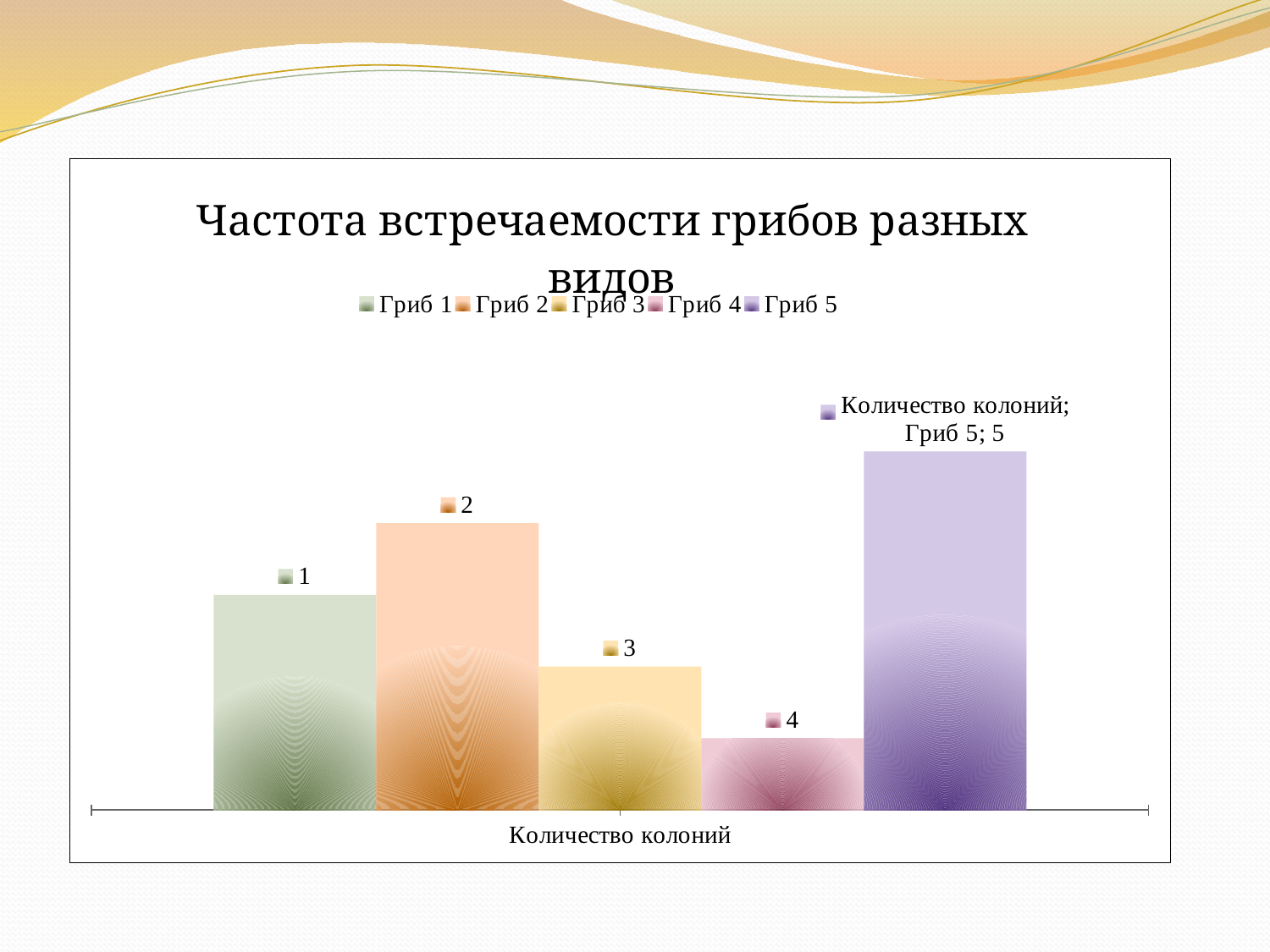
How many bars are plotted in the chart? 5 What is the title of the chart? Частота встречаемости грибов разных видов What value is shown in the data label for Гриб 5? 5 Which bar is taller, Гриб 3 or Гриб 4? Гриб 3 Which bar is taller, Гриб 1 or Гриб 3? Гриб 1 What label is shown on the horizontal axis of the chart? Количество колоний Which mushroom (Гриб) has the shortest bar? Гриб 4 How many entries does the chart legend list? 5 Which bar is taller, Гриб 1 or Гриб 2? Гриб 2 Which mushroom (Гриб) has the tallest bar? Гриб 5 What kind of chart is shown on the slide? bar chart